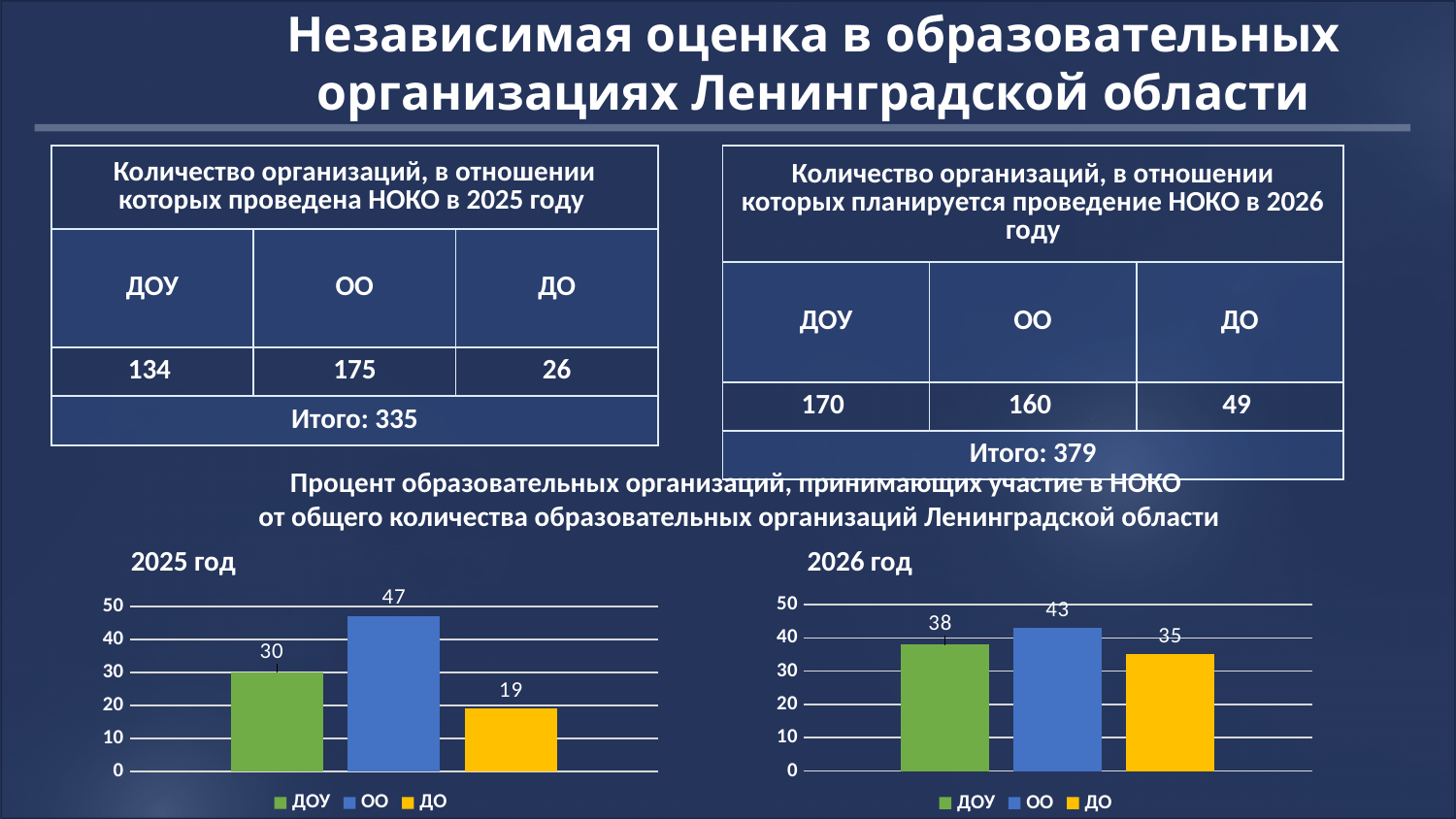
In the 2026 год chart, what is the value for ДО? 35 How many bars are plotted in the 2026 год chart? 3 What type of chart is the 2026 год chart? Bar chart In the 2025 год chart, what is the value for ДО? 19 How many series does the legend of the 2025 год chart list? 3 In the 2026 год chart, what is the value for ДОУ? 38 In the 2026 год chart, what is the difference between the values for ОО and ДОУ? 5 In the 2026 год chart, which category has the lowest value? ДО In the 2025 год chart, which category has the highest value? ОО In the 2025 год chart, which is larger, the value for ДОУ or the value for ДО? ДОУ In the 2025 год chart, what is the value for ОО? 47 In the 2025 год chart, what is the difference between the values for ОО and ДО? 28